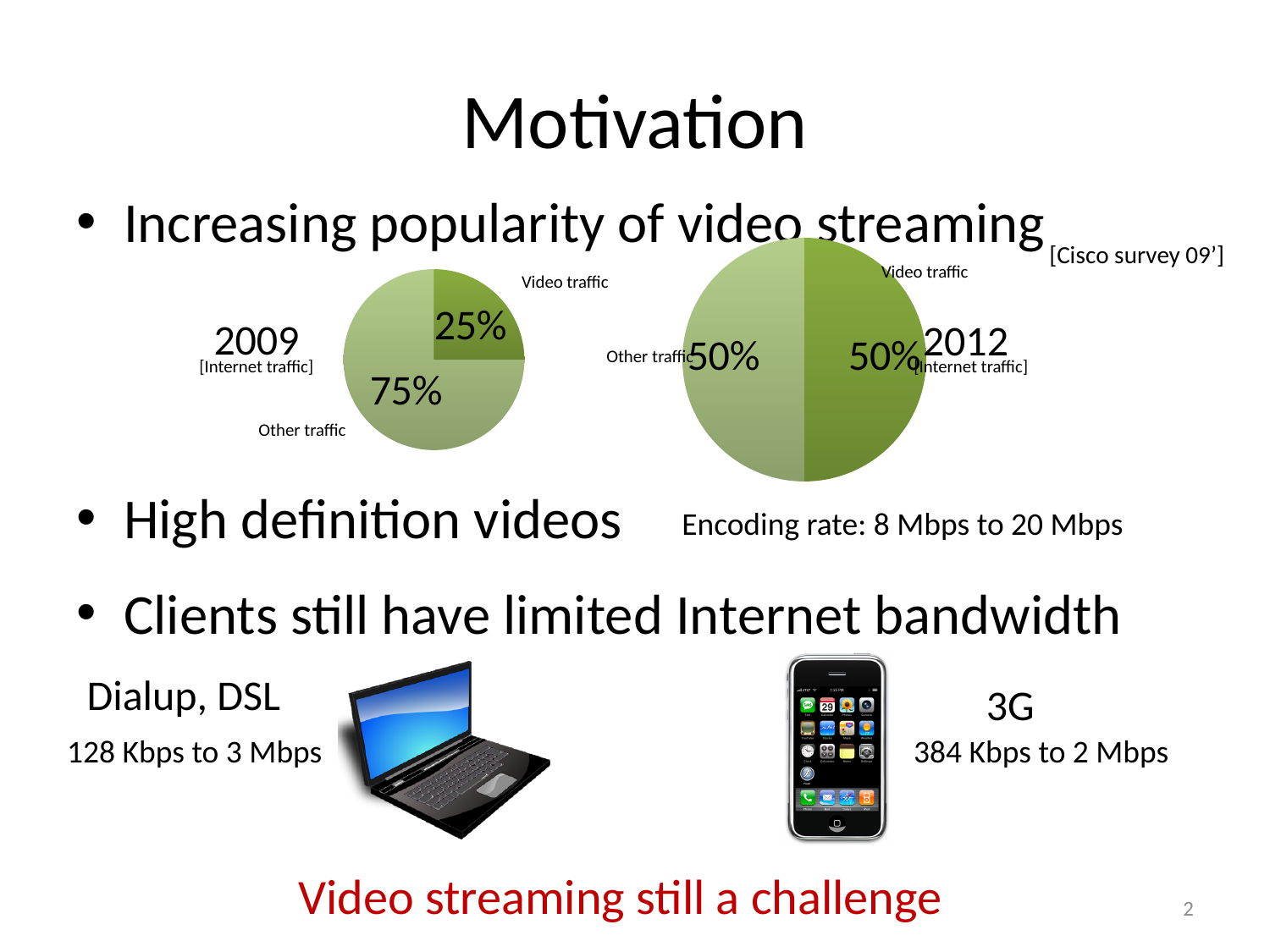
In the 2009 pie chart, what share of Internet traffic is video traffic? 25% In the 2009 pie chart, which slice is larger, video traffic or other traffic? Other traffic How many slices does the 2012 pie chart have? 2 In the 2009 pie chart, what is the difference between the other traffic share and the video traffic share? 50% Does the share of video traffic rise or fall from the 2009 pie chart to the 2012 pie chart? Rise In the 2012 pie chart, what share of Internet traffic is video traffic? 50% What kind of chart is used to show the 2009 Internet traffic breakdown? Pie chart In the 2009 pie chart, what share of Internet traffic is other traffic? 75% How much larger is the video traffic share in the 2012 pie chart than in the 2009 pie chart? 25% In the 2012 pie chart, what share of Internet traffic is other traffic? 50% How many pie charts are shown on the slide? 2 In the 2009 pie chart, which category has the smallest share? Video traffic